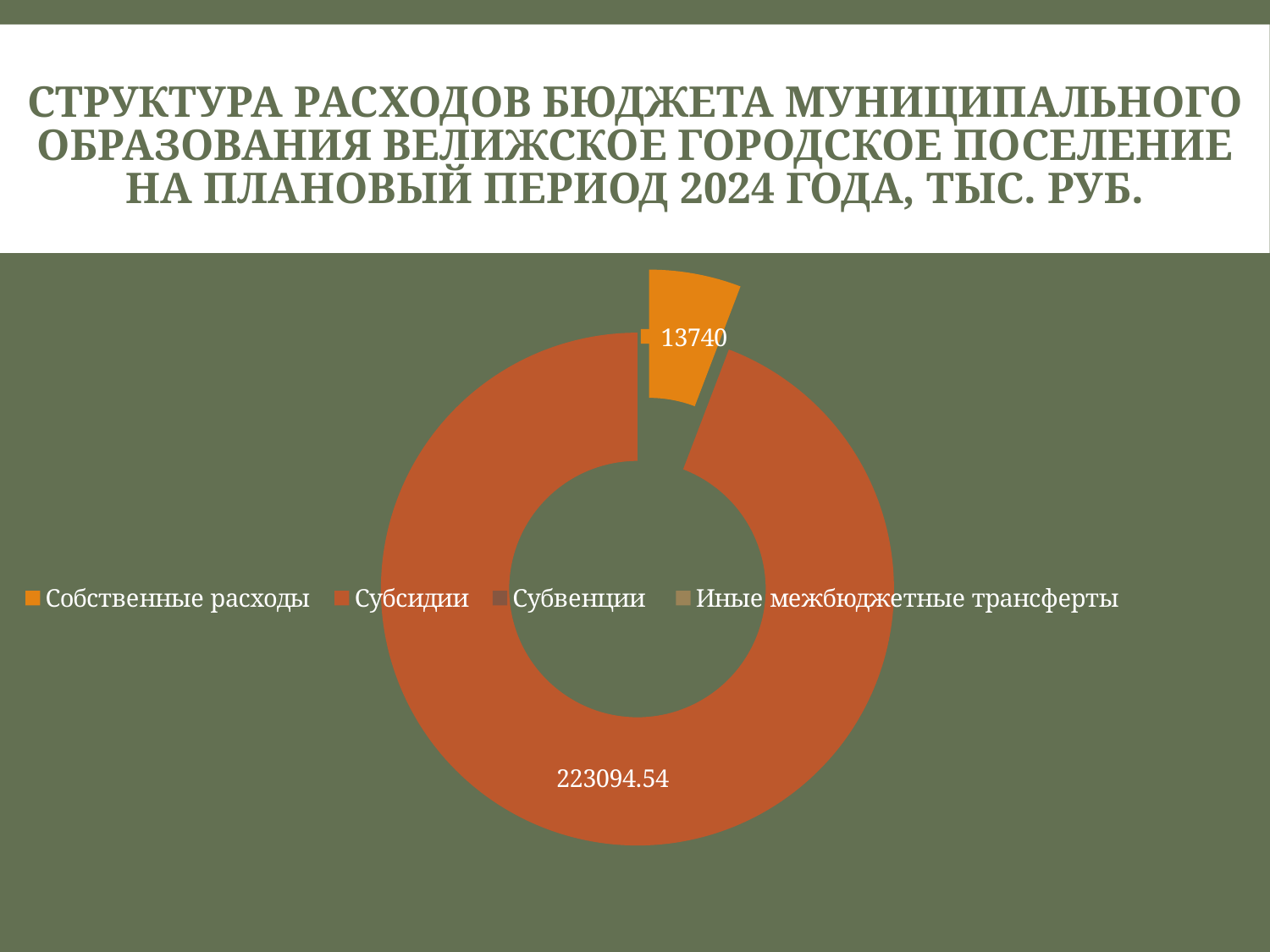
What unit of measurement is stated in the slide title? тыс. руб. Which is larger, Собственные расходы or Субсидии? Субсидии How many entries does the legend list? 4 What colour is the slice for Собственные расходы? Orange What is the total of the two labelled slices, Собственные расходы and Субсидии? 236834.54 What is the value for Собственные расходы? 13740 How many slices with data labels are visible in the chart? 2 What is the value for Субсидии? 223094.54 What is the difference between the values for Субсидии and Собственные расходы? 209354.54 Which category has the largest slice? Субсидии Which labelled category has the smallest slice? Собственные расходы What kind of chart is shown on the slide? Doughnut (pie) chart